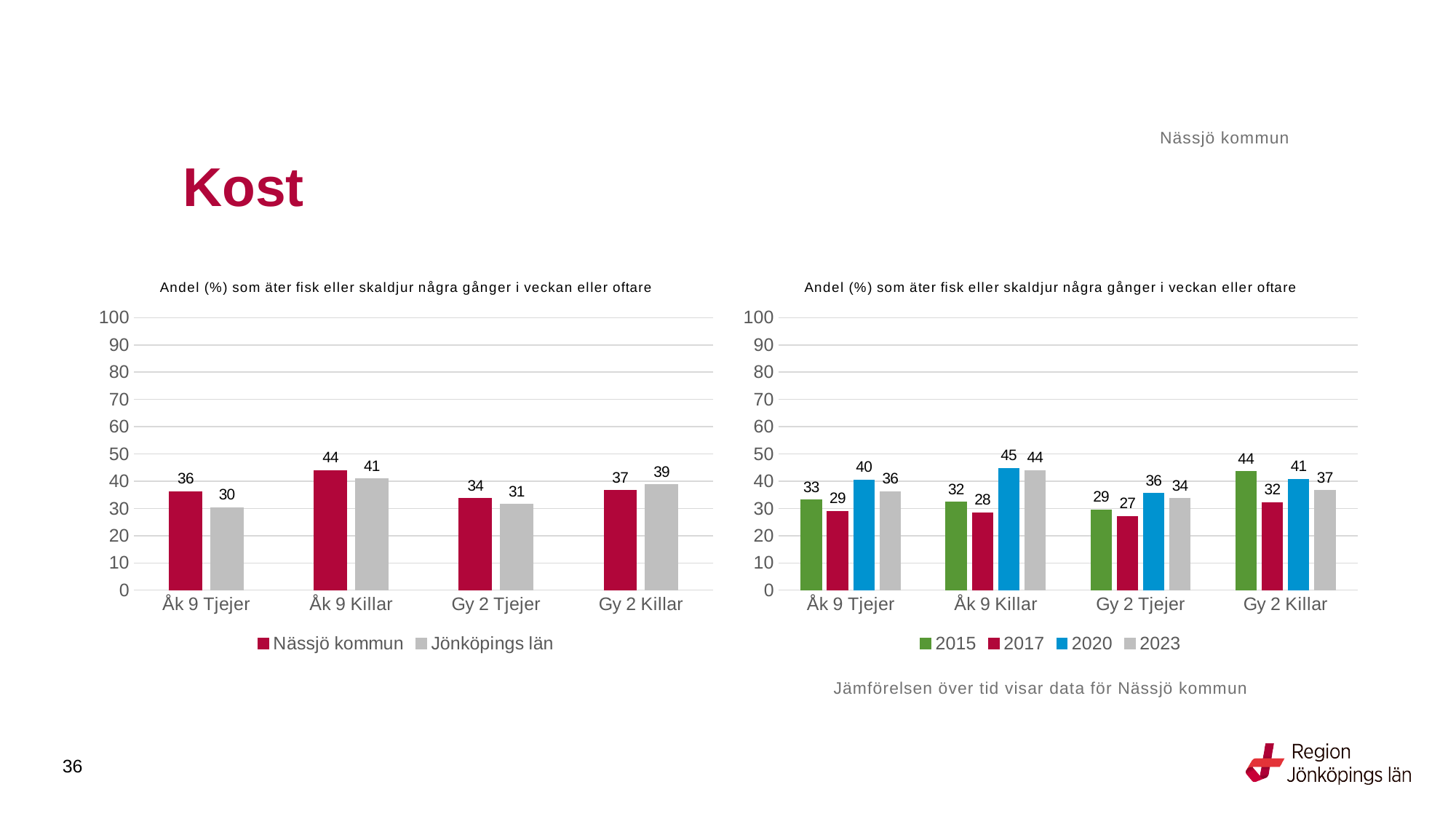
In the left chart, what is the value for Jönköpings län for Gy 2 Tjejer? 31 In the right chart, what is the value for 2015 for Gy 2 Killar? 44 In the left chart, what is the value for Nässjö kommun for Åk 9 Killar? 44 In the right chart, what is the difference between 2020 and 2017 for Åk 9 Killar? 17 In the left chart, what is the difference between Nässjö kommun and Jönköpings län for Åk 9 Tjejer? 6 In the left chart, how many series does the legend list? 2 What kind of chart is the right chart? Bar chart In the right chart, what is the value for 2020 for Åk 9 Killar? 45 In the left chart, which is larger for Gy 2 Killar: Nässjö kommun or Jönköpings län? Jönköpings län In the right chart, which category has the lowest value for 2017? Gy 2 Tjejer In the right chart, how many series does the legend list? 4 In the left chart, which category has the lowest value for Jönköpings län? Åk 9 Tjejer